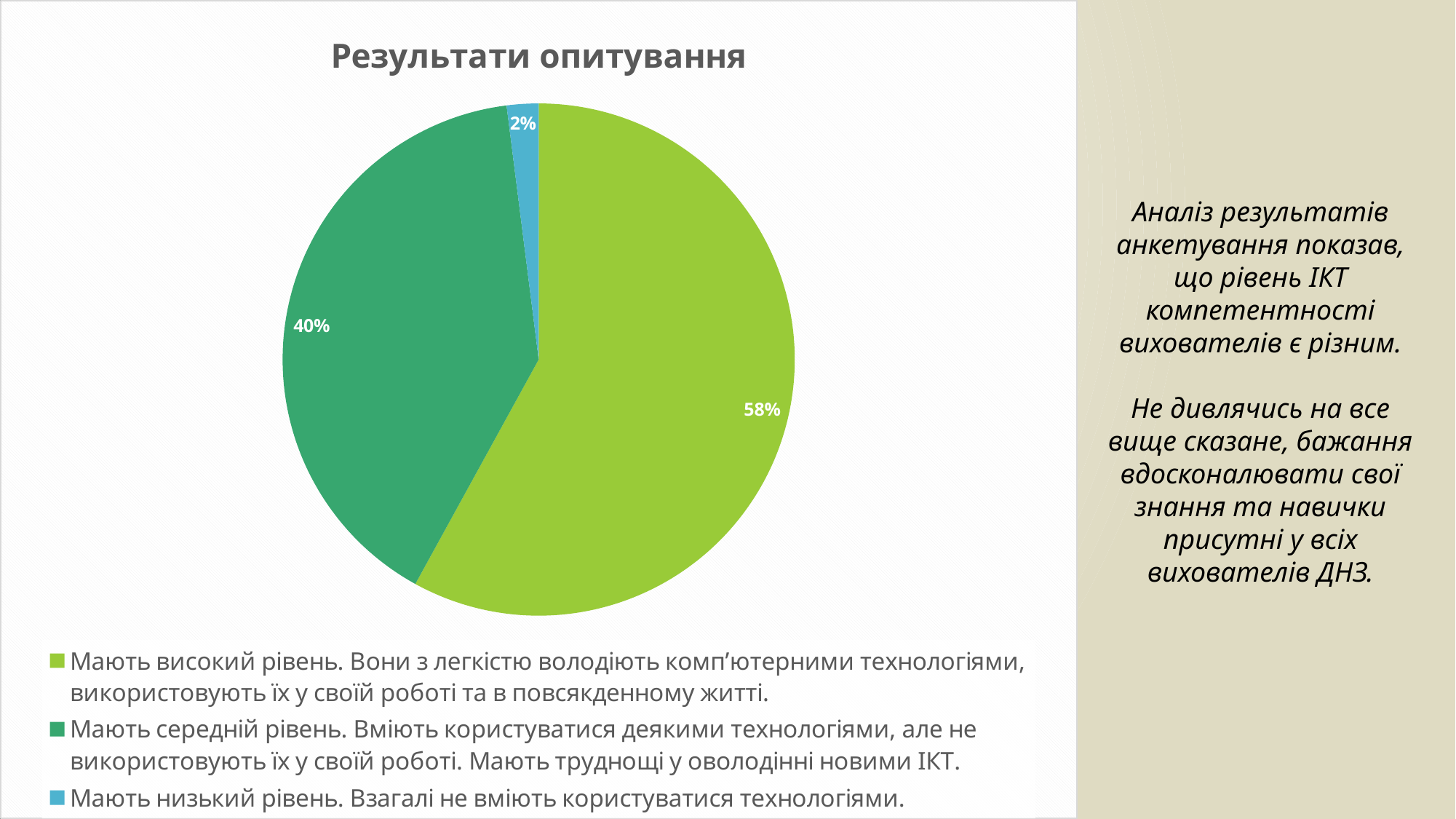
What is the difference in percentage points between the medium level and low level slices? 38 How many slices does the pie chart have? 3 What type of chart is shown on the slide? pie chart What is the title of the chart? Результати опитування What is the difference in percentage points between the high level and medium level slices? 18 Which is larger: the share with a medium level or the share with a low level? Мають середній рівень What percentage of respondents have a medium level (Мають середній рівень)? 40% What percentage of respondents have a high level (Мають високий рівень)? 58% What percentage of respondents have a low level (Мають низький рівень)? 2% Which category has the smallest share of the pie? Мають низький рівень What colour is the slice for the low level (Мають низький рівень)? blue Which category has the largest share of the pie? Мають високий рівень